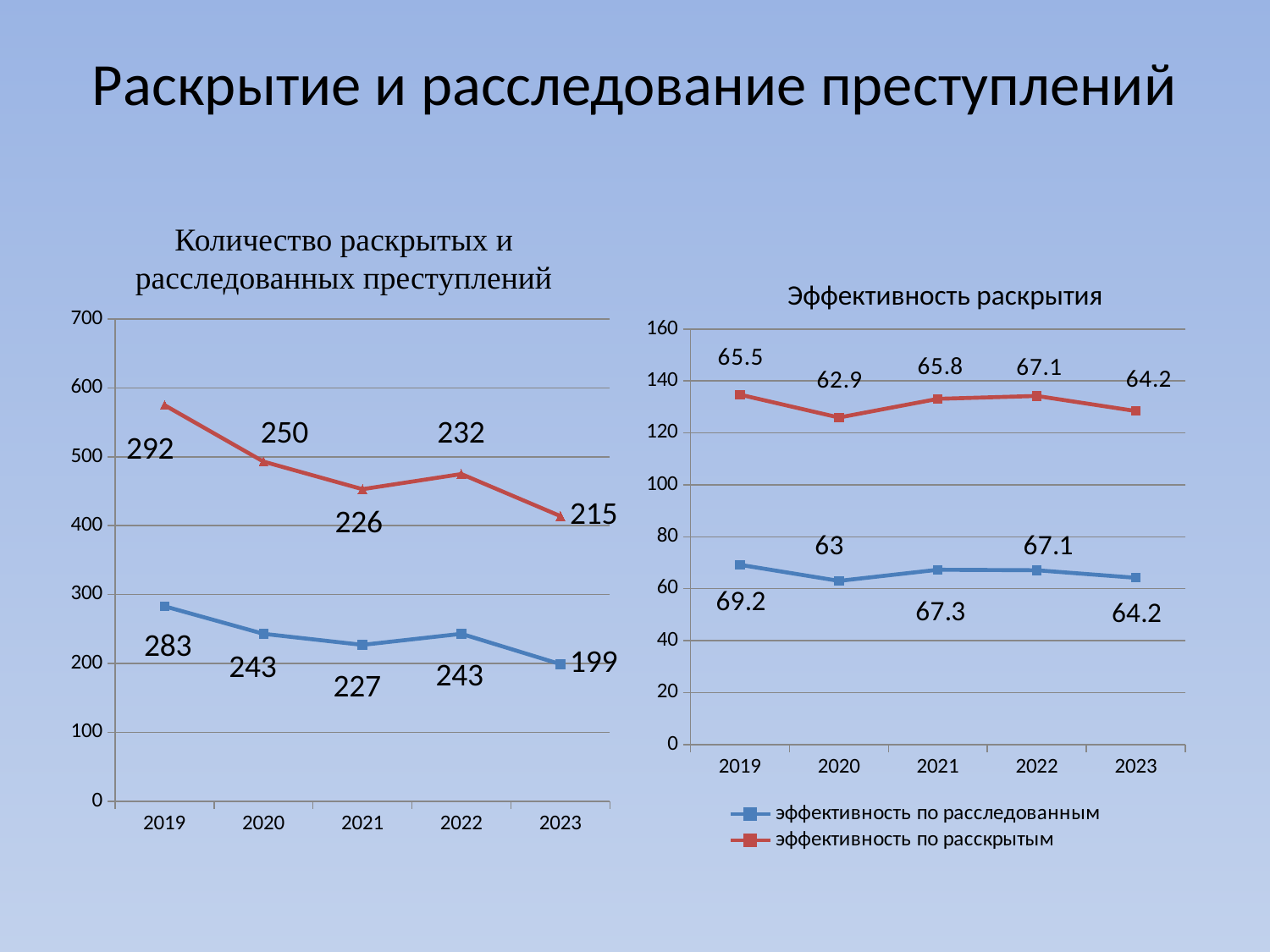
In the left chart "Количество раскрытых и расследованных преступлений", by how much did the blue line's value fall from 2019 (283) to 2023 (199)? 84 In the right chart "Эффективность раскрытия", what is the value of "эффективность по расследованным" for 2019? 69.2 In the left chart "Количество раскрытых и расследованных преступлений", what is the labelled value of the blue line for 2023? 199 In the left chart "Количество раскрытых и расследованных преступлений", does the blue line overall rise or fall from 2019 to 2023? fall How many series does the legend of the right chart "Эффективность раскрытия" list? 2 In the right chart "Эффективность раскрытия", which year has the highest value for "эффективность по расскрытым"? 2022 In the left chart "Количество раскрытых и расследованных преступлений", which year has the lowest labelled value on the blue line? 2023 In the left chart "Количество раскрытых и расследованных преступлений", what is the labelled value of the red line for 2019? 292 What kind of chart is the left chart titled "Количество раскрытых и расследованных преступлений"? line chart In the left chart "Количество раскрытых и расследованных преступлений", for 2020, which line has the larger labelled value, the red line or the blue line? the red line In the left chart "Количество раскрытых и расследованных преступлений", which year has the highest labelled value on the red line? 2019 In the left chart "Количество раскрытых и расследованных преступлений", how many years are shown on the x axis? 5